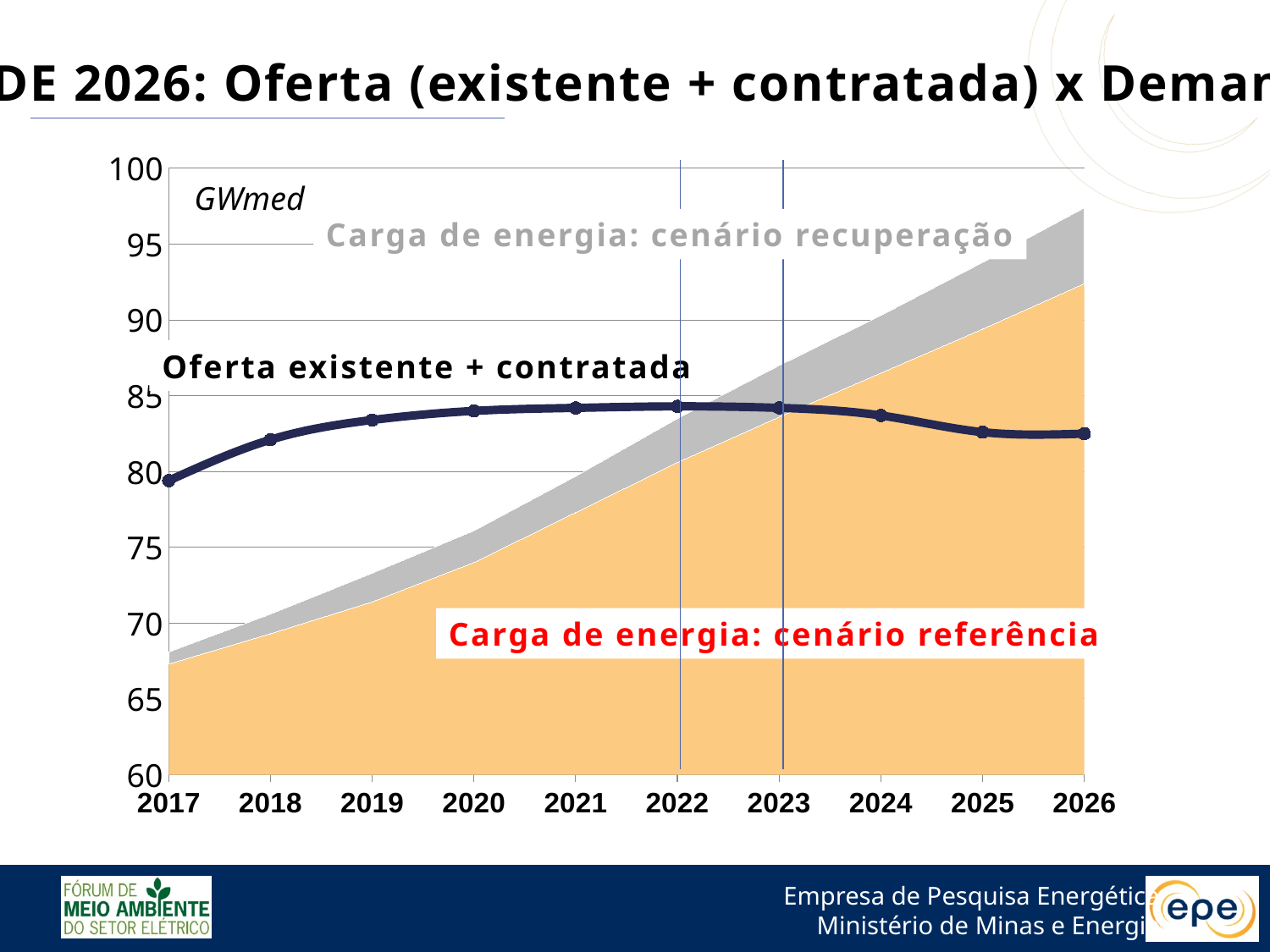
Is the value of 'Oferta existente + contratada' in 2026 greater or less than 85? less What kind of chart is shown on the slide? line and area chart In 2026, which is higher: 'Oferta existente + contratada' or 'Carga de energia: cenário referência'? Carga de energia: cenário referência How many data series are labelled on the chart? 3 Is the value of 'Carga de energia: cenário recuperação' in 2026 greater or less than 95? greater How many years are shown on the x axis of the chart? 10 Is the value of 'Carga de energia: cenário referência' in 2017 greater or less than 70? less In 2017, which is higher: 'Oferta existente + contratada' or 'Carga de energia: cenário recuperação'? Oferta existente + contratada What unit is indicated for the values on the chart? GWmed Does 'Carga de energia: cenário referência' rise or fall from 2017 to 2026? rise What colour is the area for 'Carga de energia: cenário referência'? orange